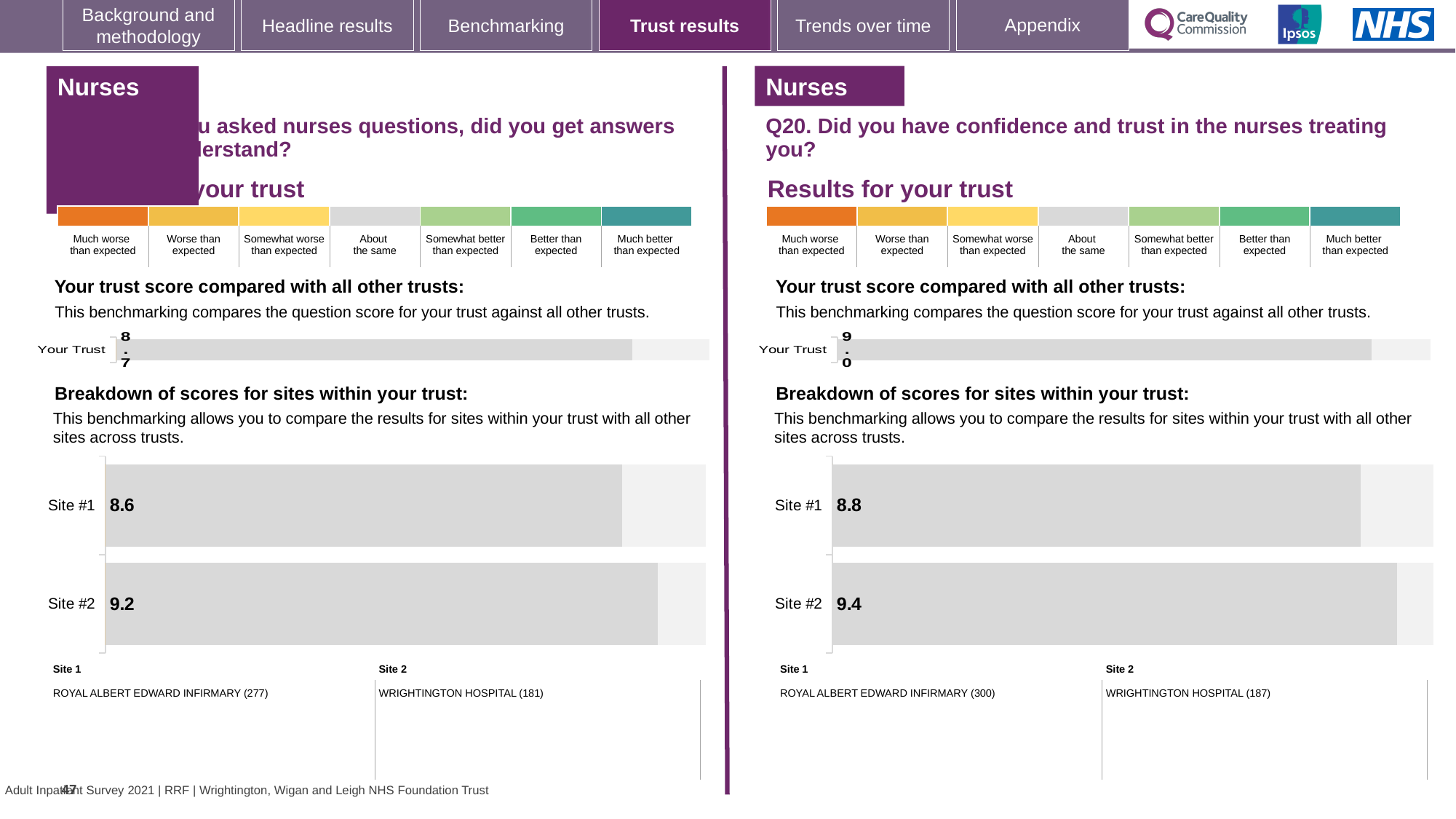
In the site breakdown chart on the left half of the slide, which site has the lower score? Site #1 In the site breakdown chart on the right half of the slide (Q20), what is the difference between the Site #2 and Site #1 scores? 0.6 In the site breakdown chart on the left half of the slide, what is the difference between the Site #2 and Site #1 scores? 0.6 What type of chart is used for the site breakdown on the left half of the slide? Bar chart In the 'Breakdown of scores for sites within your trust' chart on the left half of the slide, what is the score for Site #2? 9.2 In the 'Your trust score compared with all other trusts' chart on the right half of the slide (Q20), what is the score for Your Trust? 9.0 In the 'Your trust score compared with all other trusts' chart on the left half of the slide, what is the score for Your Trust? 8.7 In the 'Breakdown of scores for sites within your trust' chart on the right half of the slide (Q20), what is the score for Site #2? 9.4 In the 'Breakdown of scores for sites within your trust' chart on the left half of the slide, what is the score for Site #1? 8.6 In the site breakdown chart on the right half of the slide (Q20), which site has the higher score? Site #2 How many sites are shown in the site breakdown chart on the right half of the slide (Q20)? 2 In the 'Breakdown of scores for sites within your trust' chart on the right half of the slide (Q20), what is the score for Site #1? 8.8